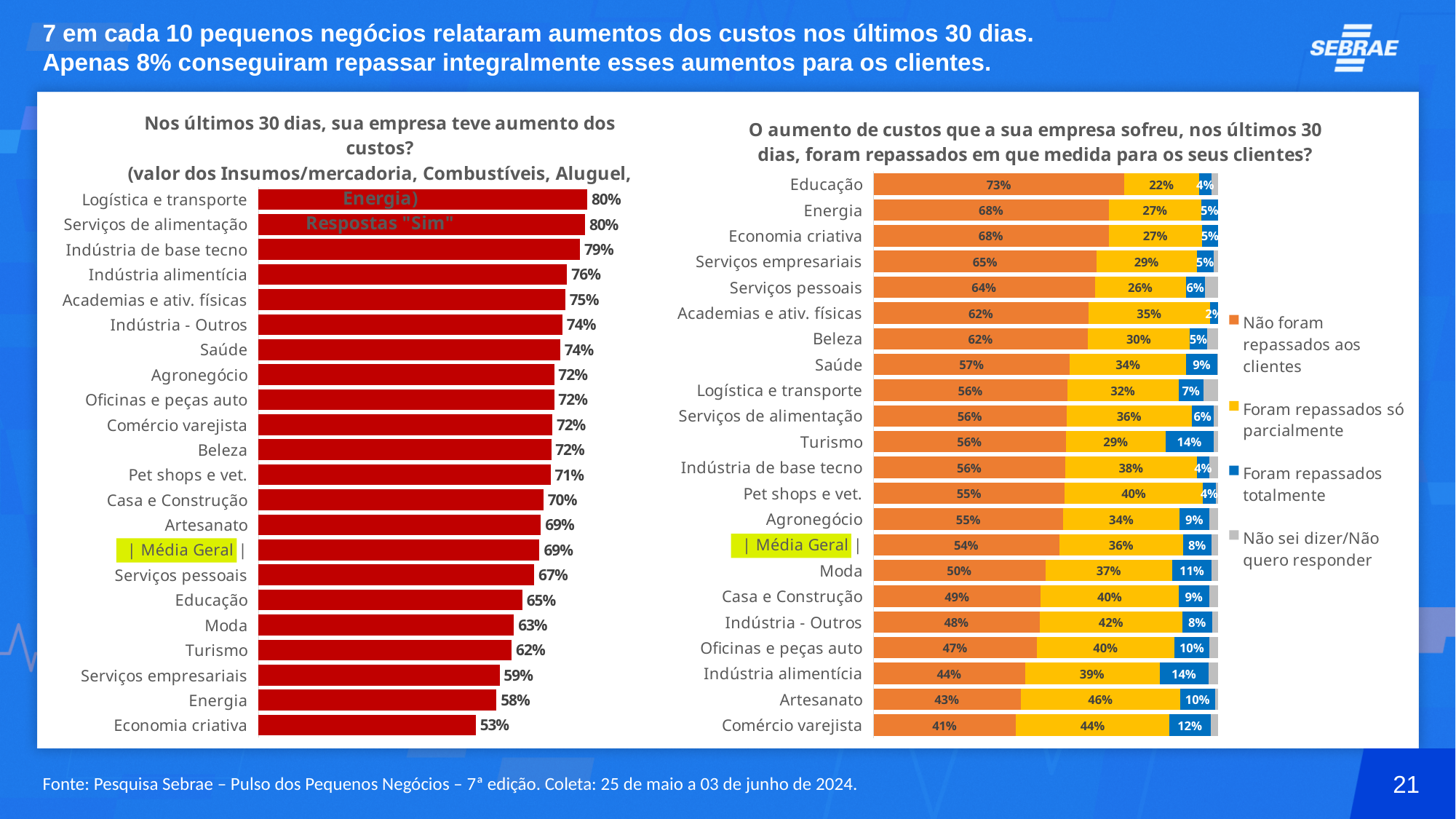
In the left chart, what is the difference between the values for Logística e transporte and Economia criativa? 27% How many categories are shown in the right chart? 22 In the right chart, what is the difference between the "Não foram repassados aos clientes" values for Educação and Comércio varejista? 32% In the left chart, what is the value for Média Geral? 69% In the right chart, which category has the highest value for "Foram repassados só parcialmente"? Artesanato In the left chart ("Nos últimos 30 dias, sua empresa teve aumento dos custos?"), what is the value for Saúde? 74% In the left chart, which is larger: the value for Turismo or the value for Moda? Moda In the right chart, what is the value of "Foram repassados totalmente" for Turismo? 14% In the right chart, how many series does the legend list? 4 In the left chart, which category has the lowest value? Economia criativa What kind of chart is the left chart? Bar chart In the right chart ("O aumento de custos que a sua empresa sofreu..."), what is the value of "Não foram repassados aos clientes" for Educação? 73%